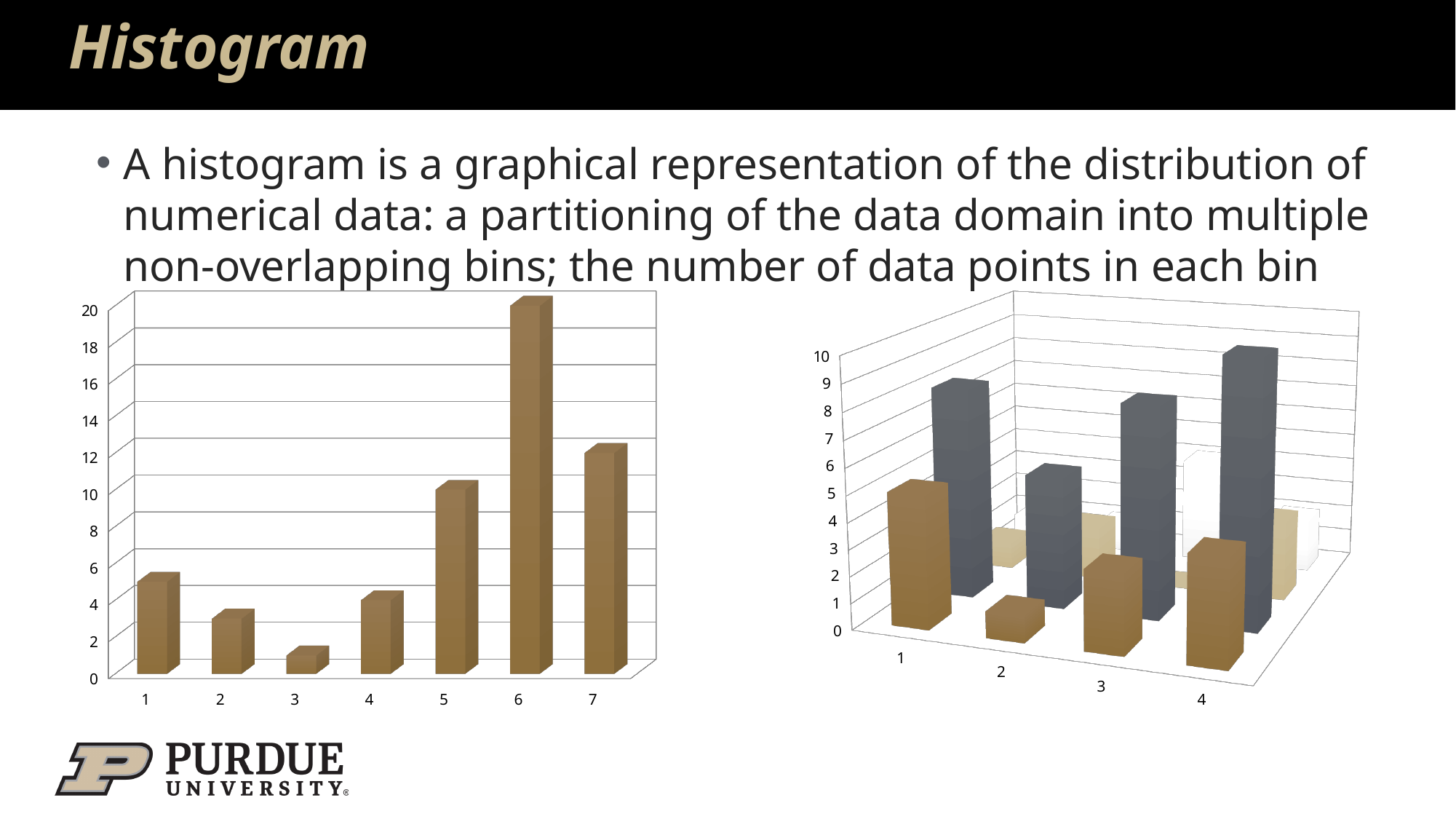
In the left chart, which is larger, the value for category 5 or the value for category 7? category 7 In the left chart, how many categories are shown on the x axis? 7 In the left chart, which is larger, the value for category 1 or the value for category 3? category 1 In the left chart, is the value for category 2 greater or less than 6? less In the left chart, which category has the lowest value? 3 In the left chart, which category has the highest value? 6 What type of chart is the right chart on the slide? bar chart In the left chart, what is the value for category 6? 20 What type of chart is the left chart on the slide? bar chart In the left chart, what is the value for category 7? 12 In the left chart, is the value for category 1 greater or less than 10? less In the right chart, how many categories are shown on the x axis? 4